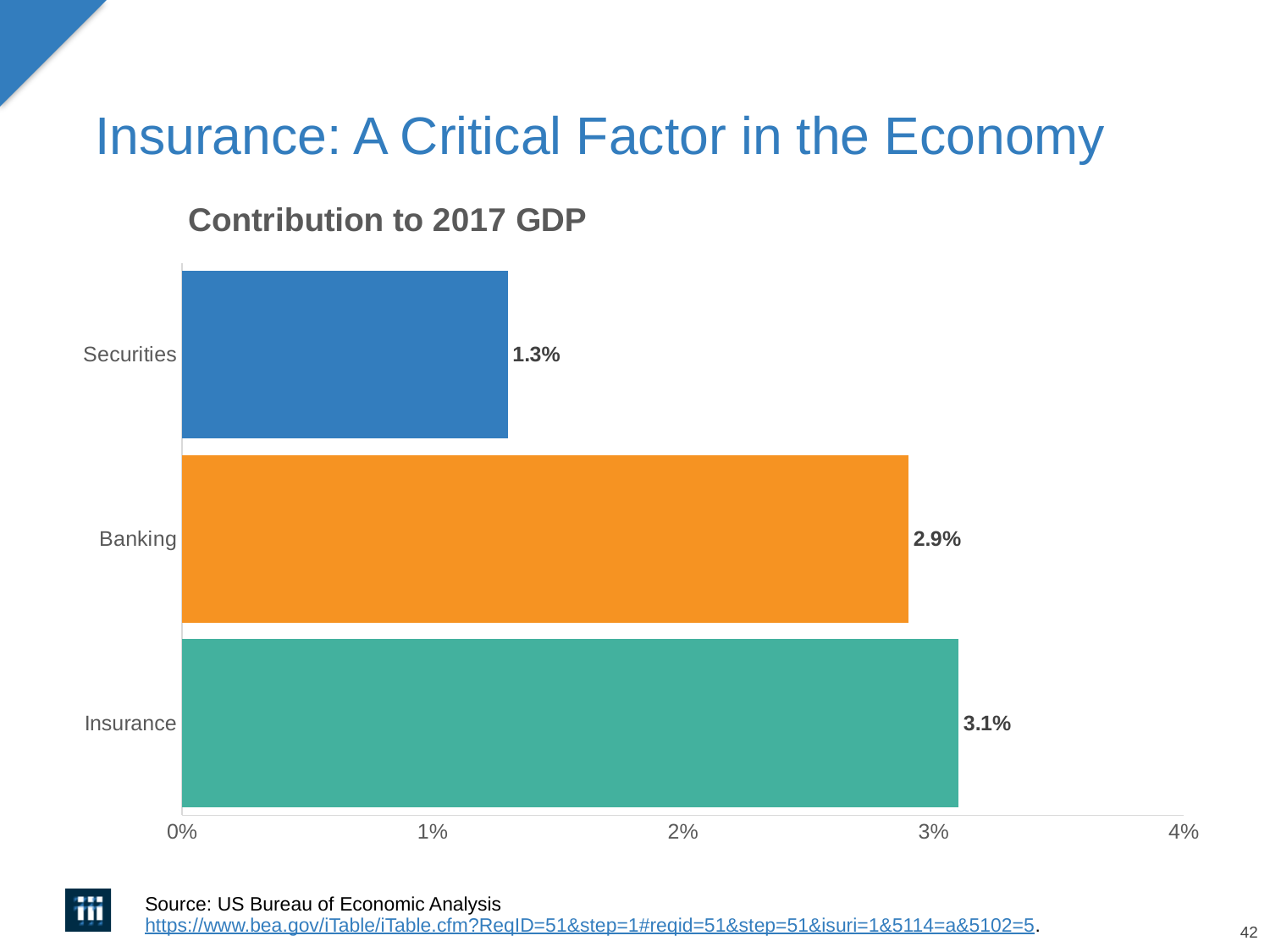
How many categories are shown in the chart? 3 What is the title of the chart? Contribution to 2017 GDP Which category has the lowest contribution to 2017 GDP? Securities What is the difference between the Banking and Securities contributions to 2017 GDP? 1.6% What kind of chart is shown on the slide? Bar chart Which has a larger contribution to 2017 GDP, Banking or Securities? Banking Is the value for Banking greater or less than 2%? greater Which category has the highest contribution to 2017 GDP? Insurance What is the difference between the Insurance and Securities contributions to 2017 GDP? 1.8% What is the contribution to 2017 GDP for Securities? 1.3% What is the contribution to 2017 GDP for Banking? 2.9% What is the contribution to 2017 GDP for Insurance? 3.1%